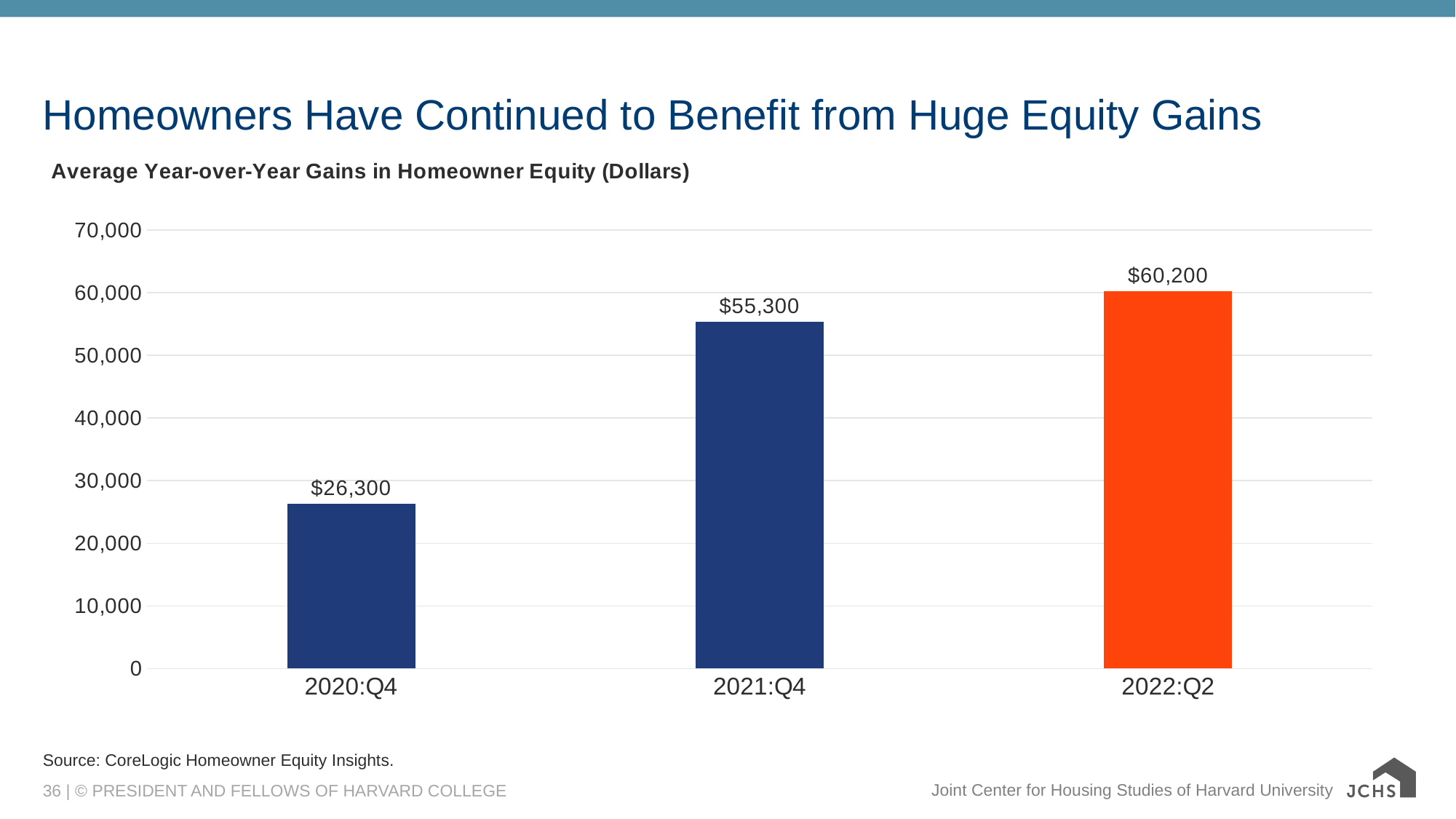
Which is larger, the equity gain in 2020:Q4 or in 2021:Q4? 2021:Q4 Do the values rise or fall from 2020:Q4 to 2022:Q2? Rise What is the average year-over-year gain in homeowner equity for 2020:Q4? $26,300 Is the value for 2022:Q2 greater or less than 60,000? greater Which period has the lowest average year-over-year gain in homeowner equity? 2020:Q4 What is the average year-over-year gain in homeowner equity for 2021:Q4? $55,300 What kind of chart is shown on the slide? Bar chart How many periods are shown on the chart? 3 What is the average year-over-year gain in homeowner equity for 2022:Q2? $60,200 What is the difference between the equity gain in 2021:Q4 and the gain in 2020:Q4? $29,000 Which period has the highest average year-over-year gain in homeowner equity? 2022:Q2 What is the difference between the equity gain in 2022:Q2 and the gain in 2021:Q4? $4,900